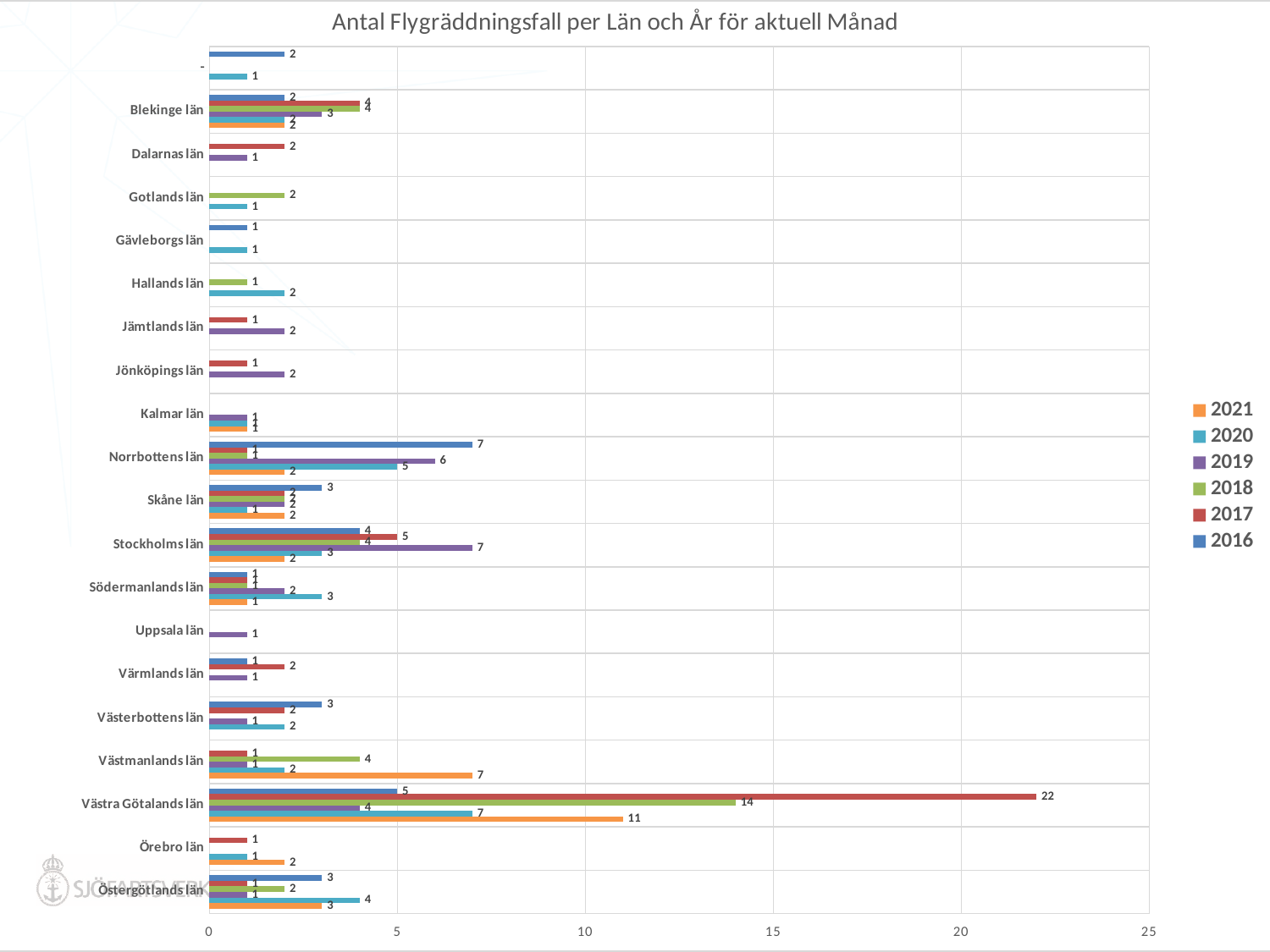
What is the value for Västmanlands län in 2021? 7 What is the value for Stockholms län in 2019? 7 What is the value for Västra Götalands län in 2017? 22 What kind of chart is shown on the slide? bar chart What is the title of the chart? Antal Flygräddningsfall per Län och År för aktuell Månad What is the difference between the 2017 and 2018 values for Västra Götalands län? 8 What is the value for Västra Götalands län in 2021? 11 How many series does the legend list? 6 Which county has the highest value for 2017? Västra Götalands län Is the 2017 value for Västra Götalands län greater or less than 20? greater What is the value for Västmanlands län in 2018? 4 Which is larger, the 2016 value for Norrbottens län or the 2016 value for Stockholms län? Norrbottens län